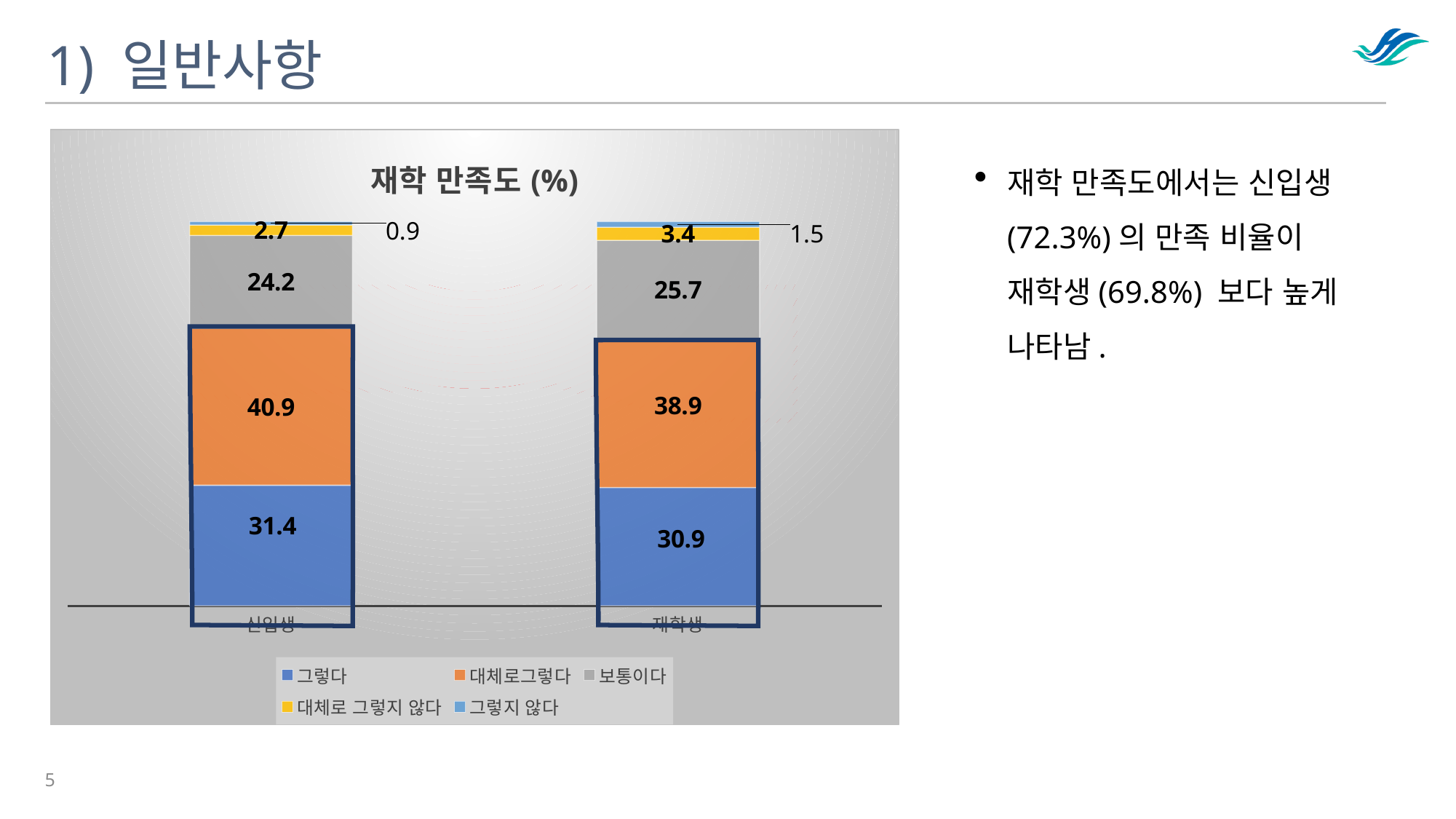
What is the value of 그렇지 않다 for 신입생? 0.9 What is the value of 보통이다 for 재학생? 25.7 What is the value of 대체로그렇다 for 재학생? 38.9 What is the value of 그렇다 for 신입생? 31.4 Which category has the larger 보통이다 value, 신입생 or 재학생? 재학생 What is the combined value of 그렇다 and 대체로그렇다 for 신입생? 72.3 How many categories are shown on the x axis? 2 How many series does the legend list? 5 Which colour represents 대체로 그렇지 않다 in the chart? Yellow What is the difference between the 대체로그렇다 values for 신입생 and 재학생? 2.0 What kind of chart is shown on the slide? Stacked bar chart What is the title of the chart? 재학 만족도 (%)